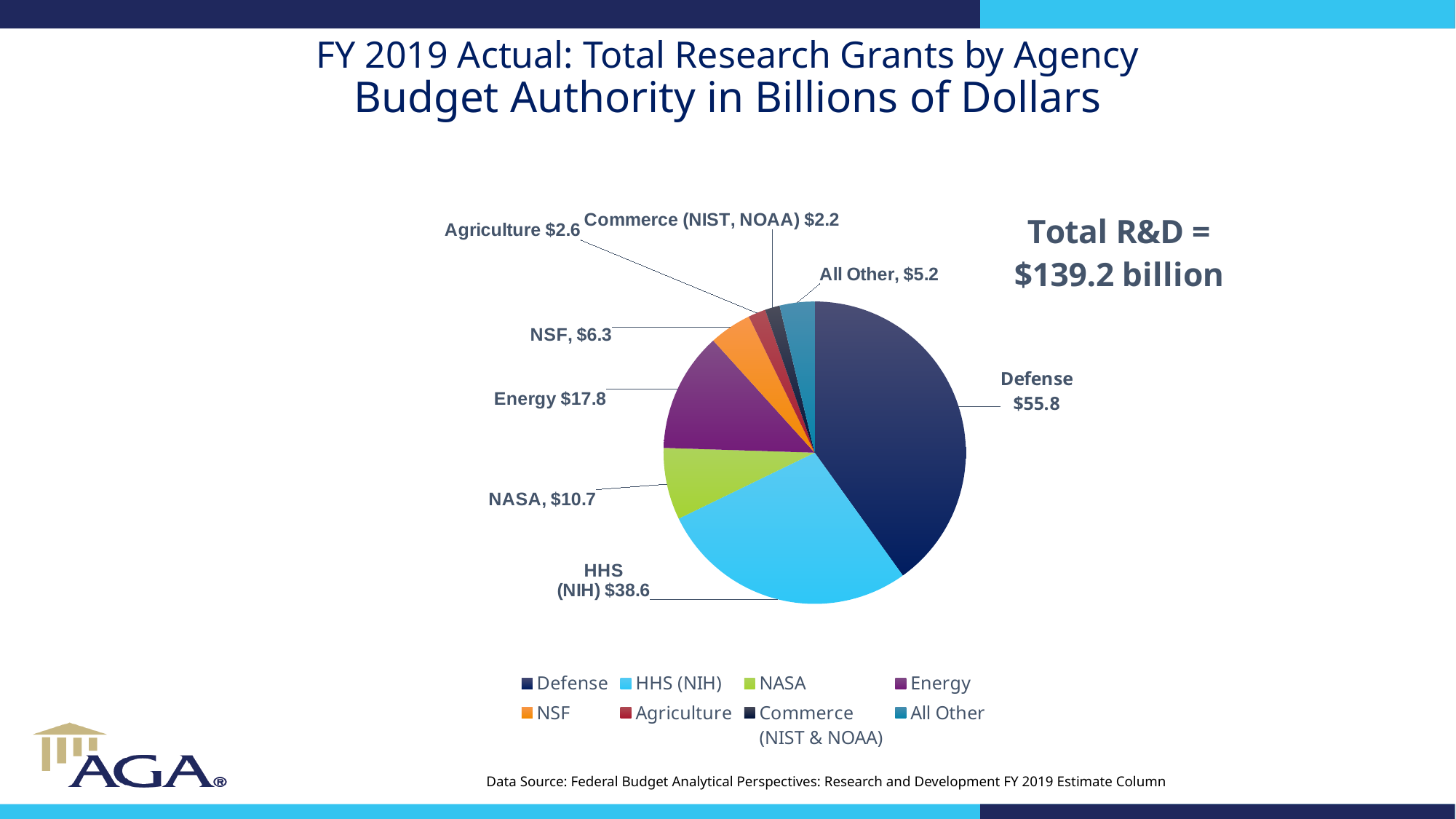
Which is larger, the value for NSF or the value for All Other? NSF What kind of chart is shown on the slide? Pie chart Which agency has the largest slice of the pie chart? Defense Which agency has the smallest slice of the pie chart? Commerce (NIST, NOAA) What is the difference between the Defense and HHS (NIH) values? $17.2 What is the difference between the Energy and NASA values? $7.1 What is the value for Energy in the pie chart? $17.8 What total R&D figure is stated next to the pie chart? $139.2 billion What is the value for Defense in the pie chart? $55.8 What is the value for Commerce (NIST, NOAA) in the pie chart? $2.2 How many slices does the pie chart have? 8 What is the value for HHS (NIH) in the pie chart? $38.6